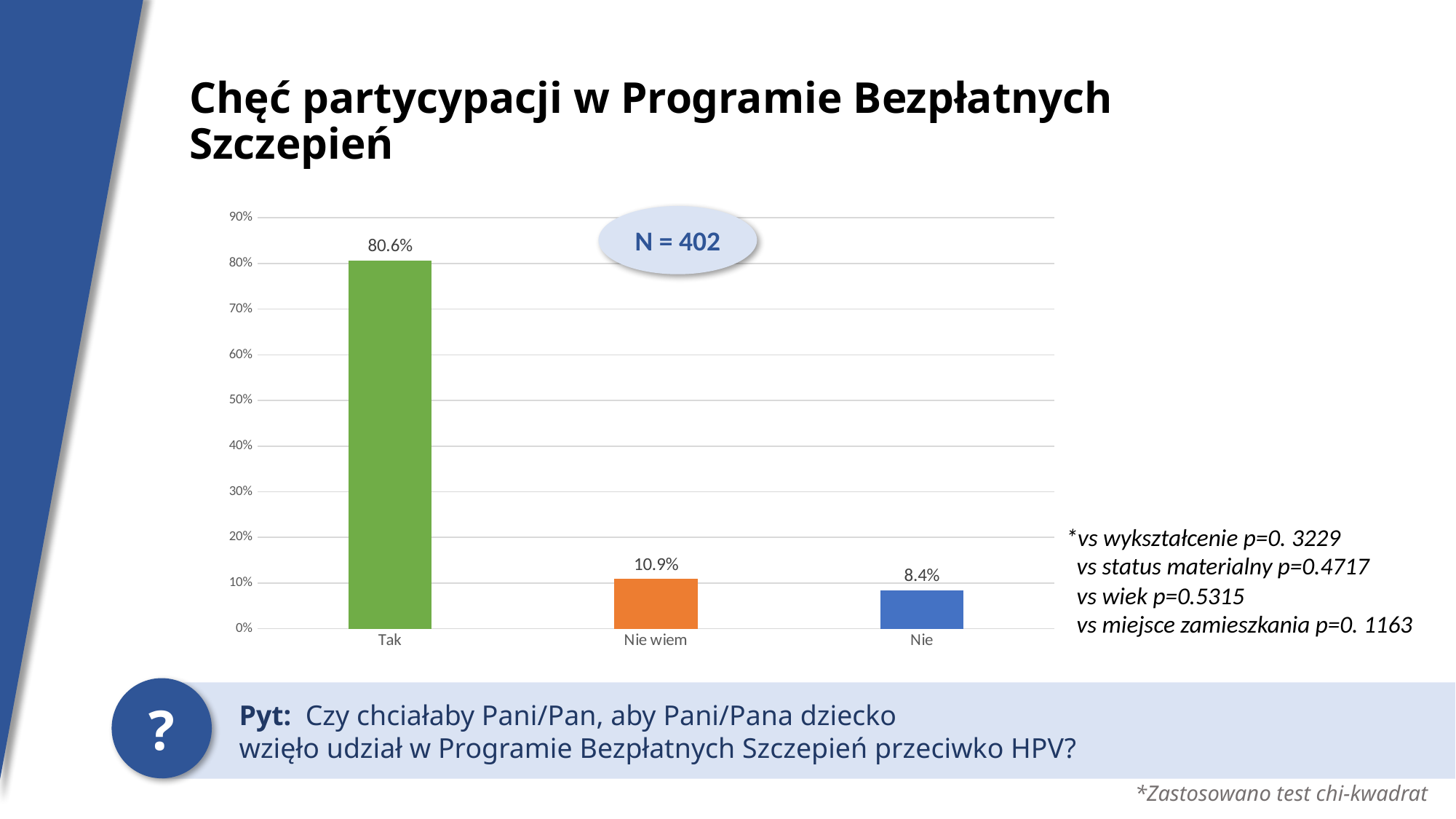
What is the difference between the values for Nie wiem and Nie? 2.5% What is the value for Tak? 80.6% What is the value for Nie? 8.4% What kind of chart is shown on the slide? bar chart Which is larger, the value for Nie wiem or the value for Nie? Nie wiem What is the difference between the values for Tak and Nie wiem? 69.7% Which category has the lowest value? Nie Which category has the highest value? Tak Is the value for Tak greater or less than 70%? greater What sample size (N) is shown on the chart? N = 402 How many categories are shown on the x axis? 3 What is the value for Nie wiem? 10.9%